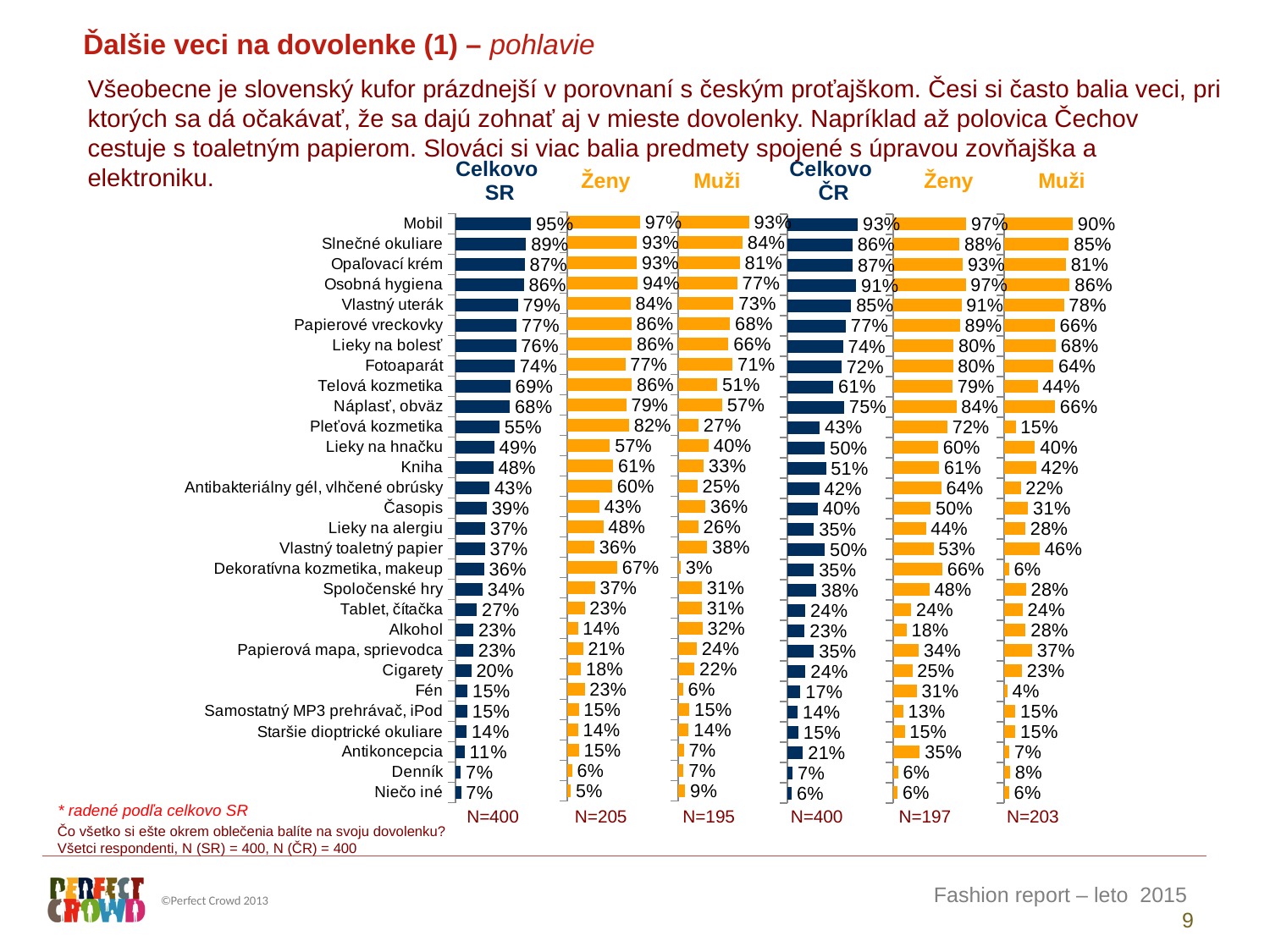
How many categories are listed in each chart? 29 In the Celkovo ČR chart, what is the value for Osobná hygiena? 91% What type of chart is used on this slide? Bar chart In the Muži chart for SR (third chart from the left), what is the value for Dekoratívna kozmetika, makeup? 3% In the Celkovo ČR chart, what is the value for Vlastný toaletný papier? 50% In the Ženy chart for ČR (fifth chart from the left), what is the value for Antikoncepcia? 35% In the Celkovo SR chart, what is the value for Mobil? 95% In the Muži chart for ČR (rightmost chart), which category has the lowest value? Fén What is the sample size (N) shown under the Muži chart for SR? N=195 Which is larger: the Celkovo SR value for Vlastný toaletný papier or the Celkovo ČR value for Vlastný toaletný papier? Celkovo ČR In the Celkovo SR chart, which category has the highest value? Mobil What is the difference between the Ženy and Muži values for Pleťová kozmetika in the SR charts? 55 percentage points